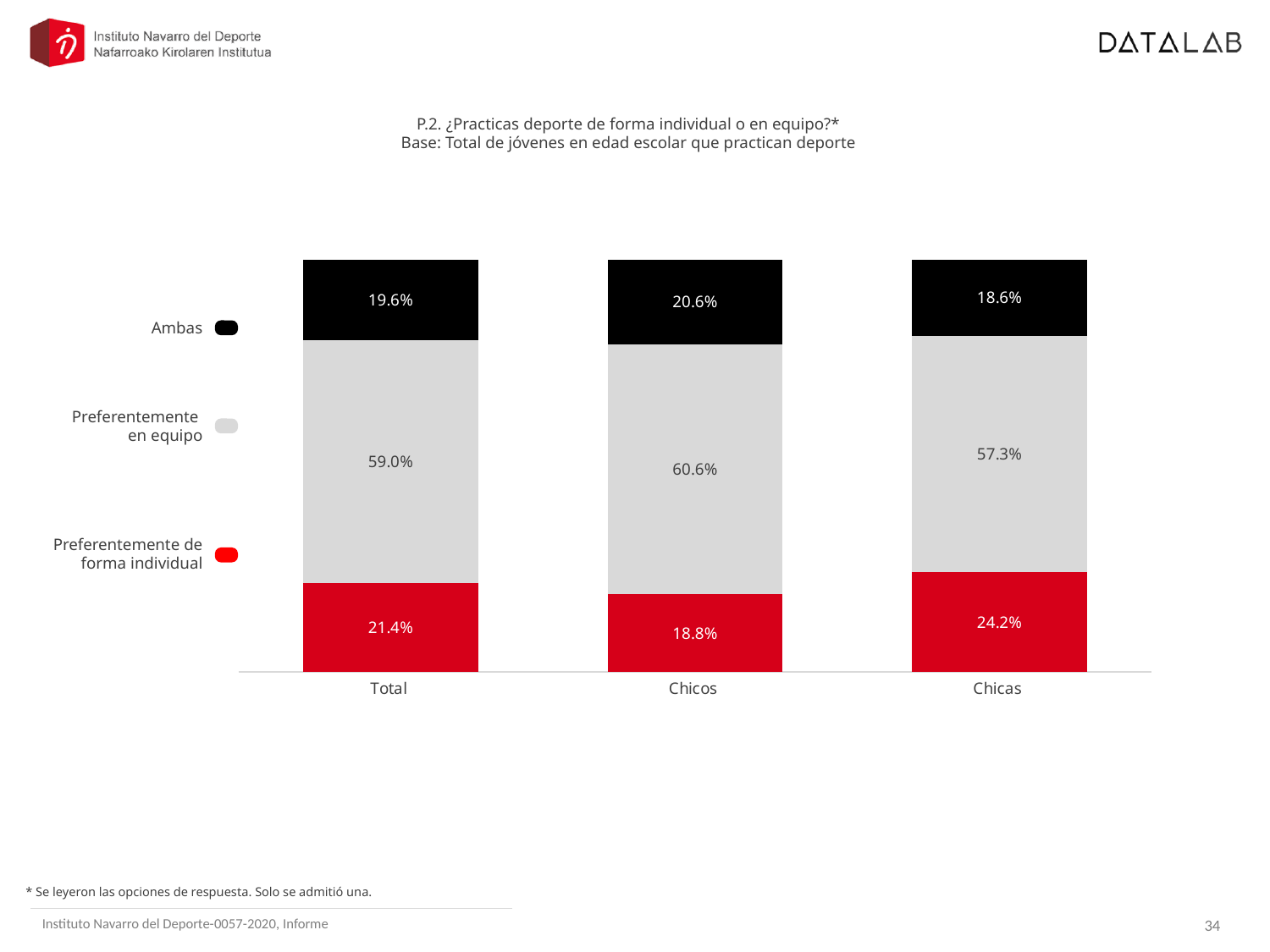
What kind of chart is shown on the slide? Stacked bar chart What percentage of the Total group answered 'Preferentemente en equipo'? 59.0% Which colour represents 'Preferentemente de forma individual' in the legend? Red Which is larger: the 'Ambas' value for Chicos or for Chicas? Chicos What is the total of the stacked bar for Chicos? 100.0% Which category has the highest value for 'Preferentemente en equipo'? Chicos How many series does the legend list? 3 What is the difference between the 'Preferentemente de forma individual' values for Chicas and Chicos? 5.4 percentage points How many categories are shown on the x axis? 3 What is the value for 'Ambas' in the Chicos bar? 20.6% Which category has the lowest value for 'Preferentemente de forma individual'? Chicos What percentage of Chicas answered 'Preferentemente de forma individual'? 24.2%